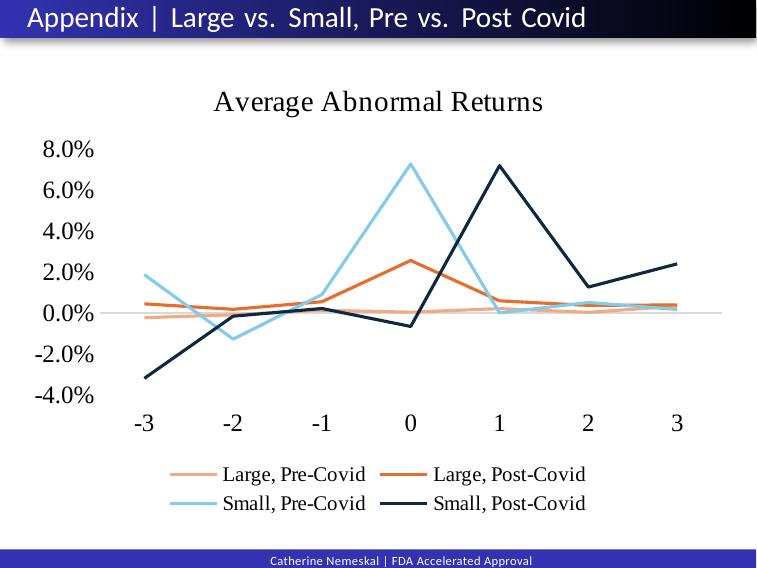
Is the value for Small, Pre-Covid at x = 0 greater or less than 6.0%? greater How many series does the legend list? 4 What is the title of the chart? Average Abnormal Returns Is the value for Small, Post-Covid at x = 1 greater or less than 6.0%? greater Which series has the highest value at x = 0? Small, Pre-Covid Which series has the lowest value at x = -3? Small, Post-Covid How many points are on the x axis of the chart? 7 What kind of chart is shown on the slide? line chart Is the value for Small, Post-Covid at x = -3 greater or less than -2.0%? less Does the Small, Post-Covid series rise or fall from x = 1 to x = 2? fall Which series has the highest value at x = 1? Small, Post-Covid